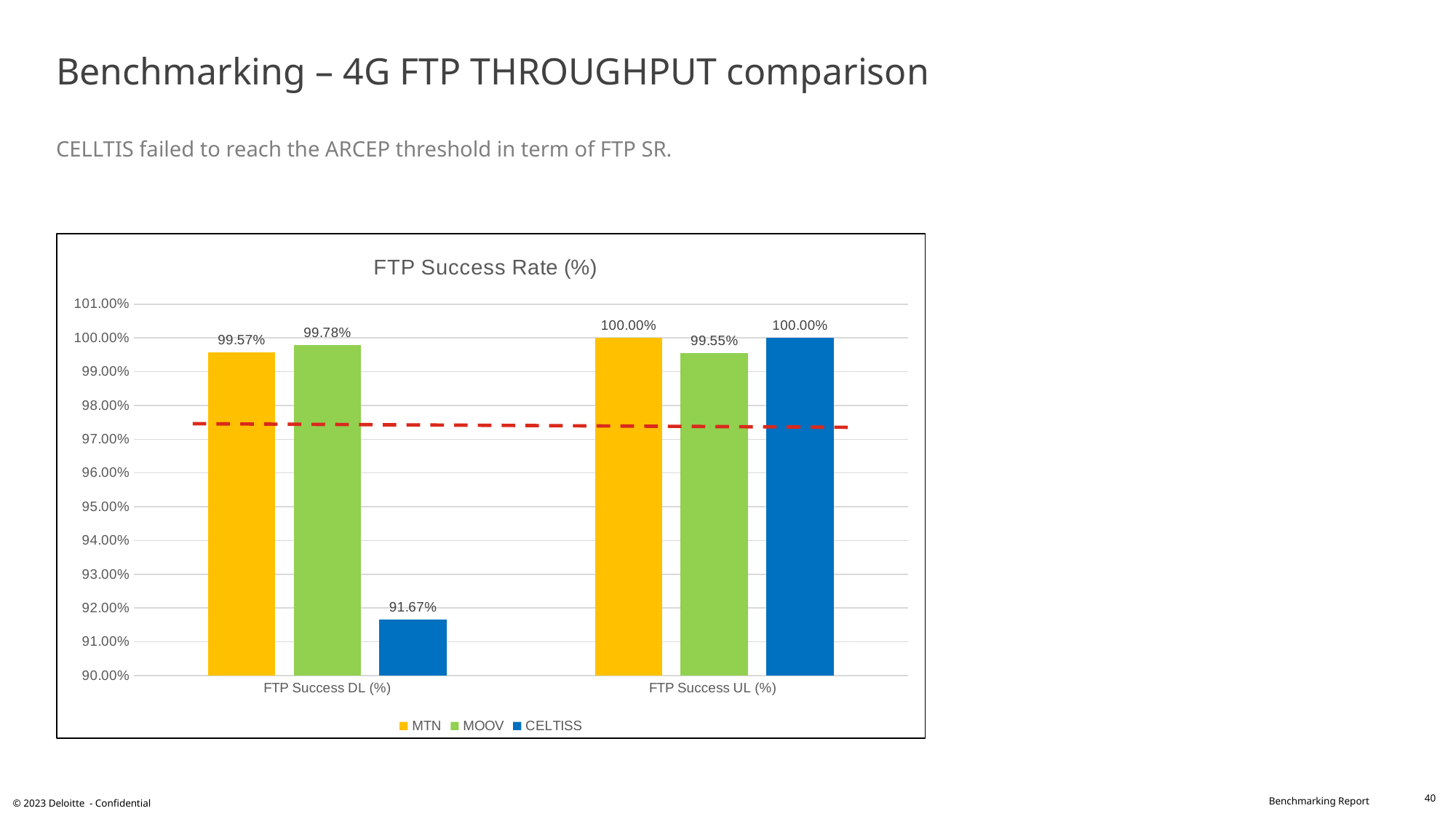
What kind of chart is shown on the slide? Bar chart Is the FTP Success DL (%) value for CELTISS greater or less than 97.00%? less How many series does the legend list? 3 Which is larger, MTN's FTP Success UL (%) or MOOV's FTP Success UL (%)? MTN Which operator has the lowest FTP Success DL (%)? CELTISS Which operator has the highest FTP Success DL (%)? MOOV What is the difference between MOOV's and CELTISS's FTP Success DL (%) values? 8.11% What is the title of the chart? FTP Success Rate (%) What is the FTP Success UL (%) value for MOOV? 99.55% How many categories are shown on the x axis? 2 What is the FTP Success DL (%) value for MTN? 99.57% What is the FTP Success DL (%) value for CELTISS? 91.67%